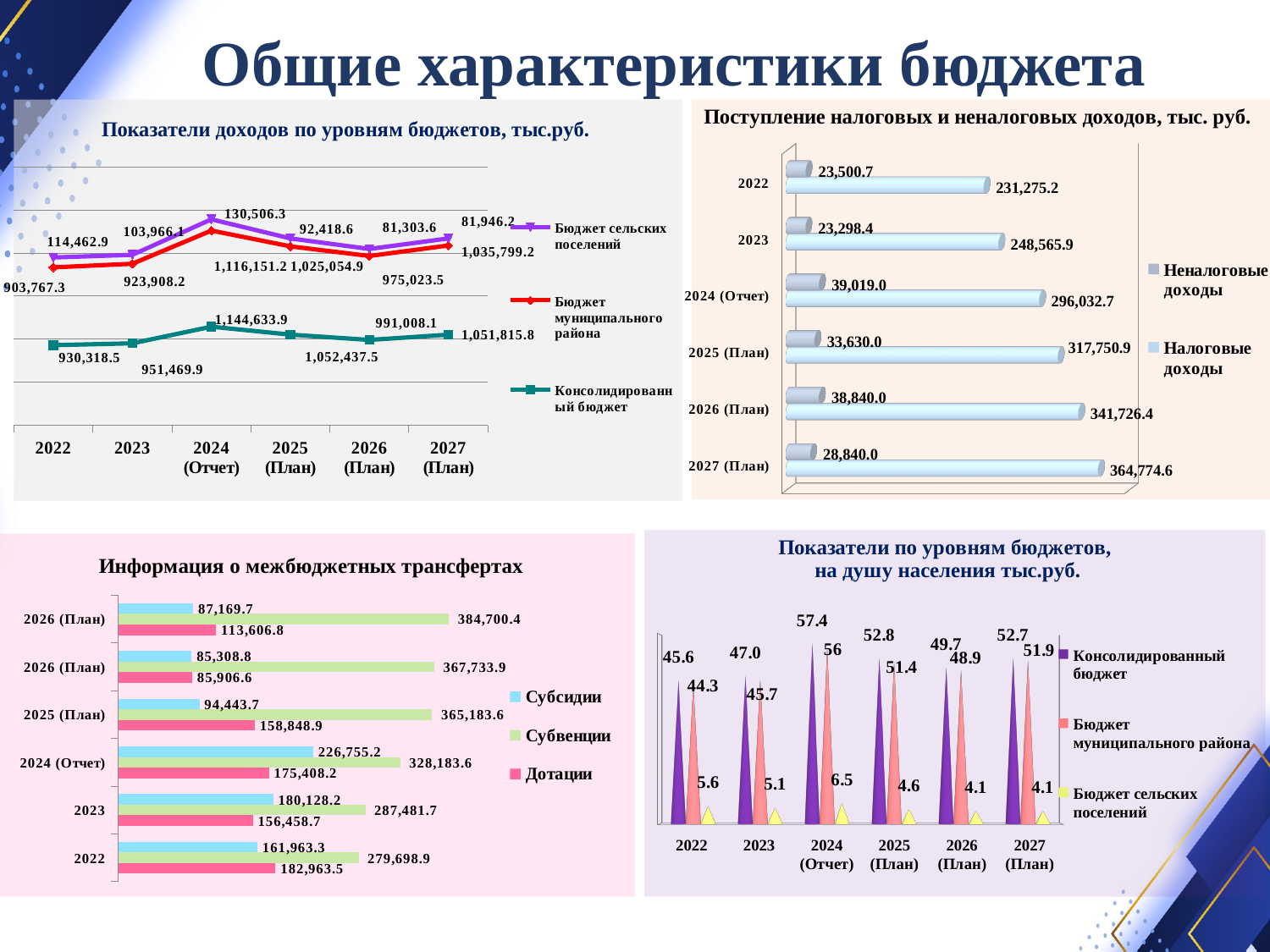
In the chart 'Поступление налоговых и неналоговых доходов, тыс. руб.', in which year is the value of Неналоговые доходы lowest? 2023 In the chart 'Информация о межбюджетных трансфертах', what is the value of Субвенции for 2024 (Отчет)? 328,183.6 In the chart 'Информация о межбюджетных трансфертах', which is larger for 2022: Субсидии or Дотации? Дотации In the chart 'Показатели доходов по уровням бюджетов, тыс.руб.', how many series does the legend list? 3 In the chart 'Поступление налоговых и неналоговых доходов, тыс. руб.', what is the difference between Налоговые доходы in 2023 and in 2022? 17,290.7 In the chart 'Поступление налоговых и неналоговых доходов, тыс. руб.', what is the value of Налоговые доходы for 2027 (План)? 364,774.6 In the chart 'Поступление налоговых и неналоговых доходов, тыс. руб.', do the Налоговые доходы values rise or fall from 2022 to 2027 (План)? rise What kind of chart is 'Информация о межбюджетных трансфертах'? bar chart In the chart 'Показатели доходов по уровням бюджетов, тыс.руб.', in which year is the value for Бюджет сельских поселений highest? 2024 (Отчет) In the chart 'Показатели по уровням бюджетов, на душу населения тыс.руб.', what is the value for Бюджет сельских поселений in 2024 (Отчет)? 6.5 In the chart 'Показатели доходов по уровням бюджетов, тыс.руб.', what is the value for Консолидированный бюджет in 2024 (Отчет)? 1,144,633.9 In the chart 'Показатели по уровням бюджетов, на душу населения тыс.руб.', what is the difference between Консолидированный бюджет and Бюджет муниципального района in 2022? 1.3